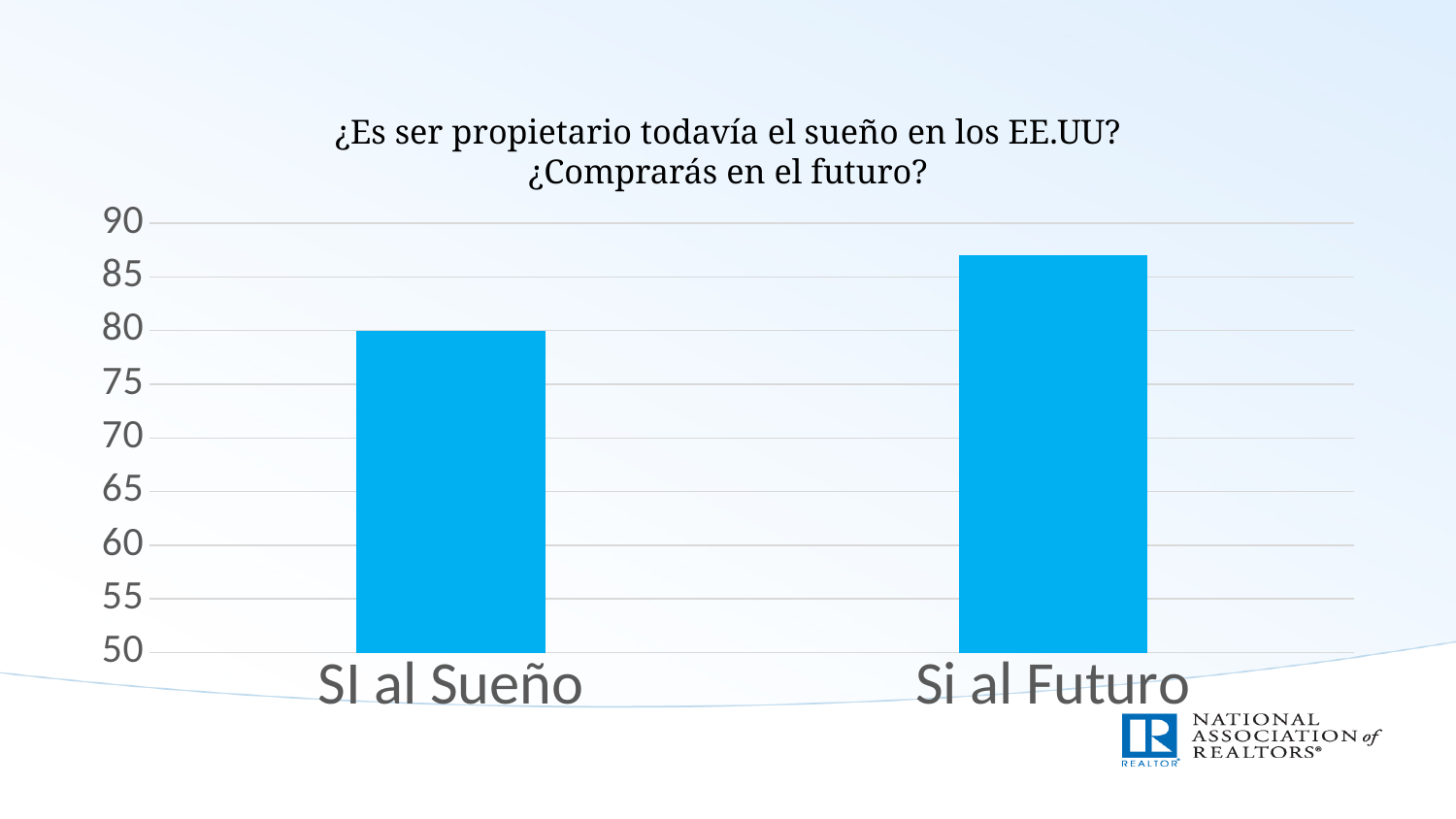
Which category has the highest value? Si al Futuro Do the values rise or fall from left to right across the categories? rise What is the title of the chart? ¿Es ser propietario todavía el sueño en los EE.UU? ¿Comprarás en el futuro? What kind of chart is shown on the slide? bar chart Which is larger, the value for SI al Sueño or the value for Si al Futuro? Si al Futuro What is the value for SI al Sueño? 80 Is the value for Si al Futuro greater or less than 90? less What colour are the bars in the chart? blue Which category has the lowest value? SI al Sueño How many bars are plotted in the chart? 2 Is the value for Si al Futuro greater or less than 85? greater Is the value for SI al Sueño greater or less than 75? greater